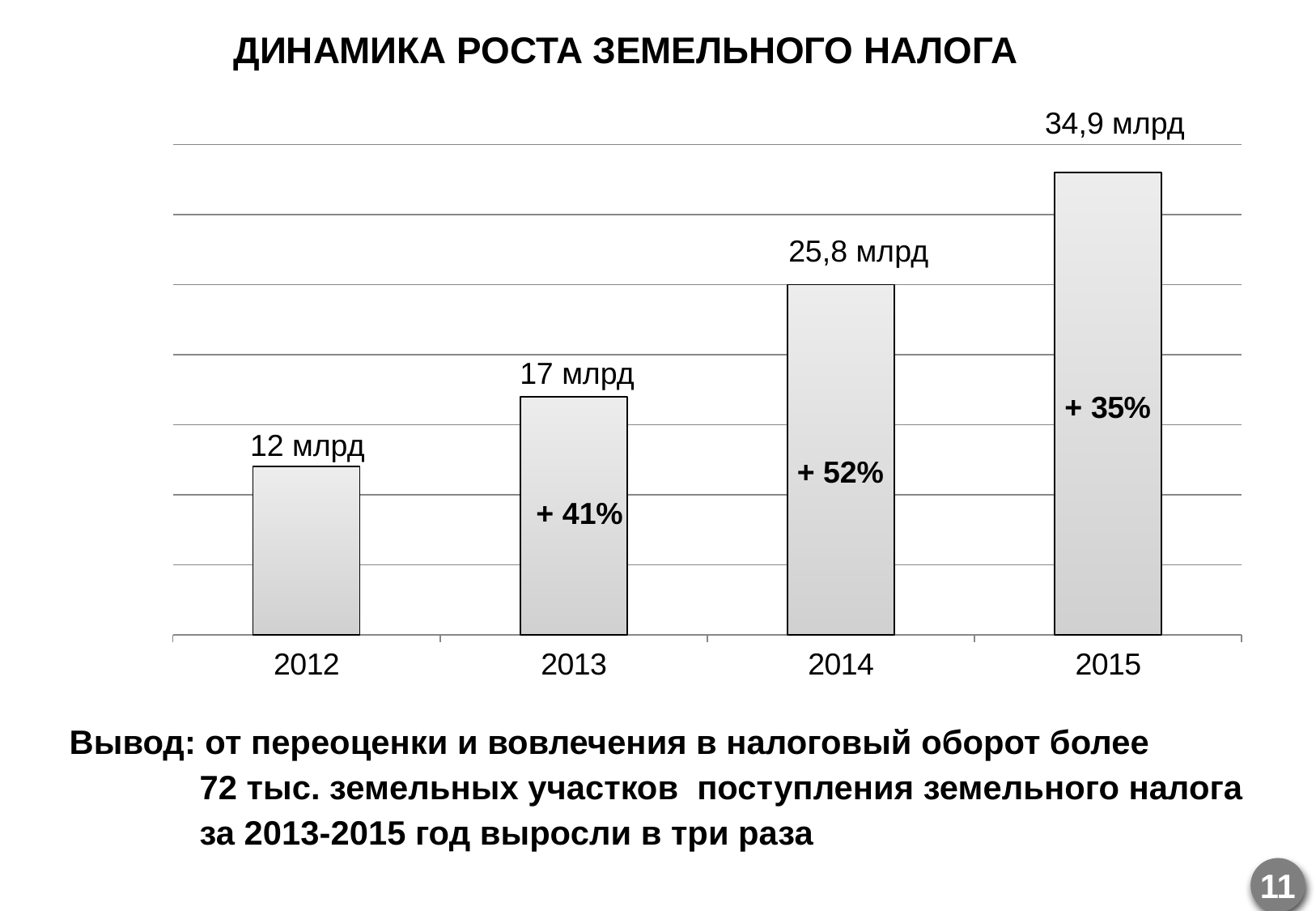
What is the value for 2013? 17 млрд Which year has the highest value? 2015 Do the values rise or fall from 2012 to 2015? rise Which is larger, the value for 2014 or the value for 2013? 2014 What is the value for 2012? 12 млрд How many years are shown on the x axis? 4 What is the difference between the values for 2013 and 2012? 5 млрд What is the value for 2015? 34,9 млрд What is the value for 2014? 25,8 млрд Which year has the lowest value? 2012 What kind of chart is this? bar chart What is the difference between the values for 2015 and 2014? 9,1 млрд